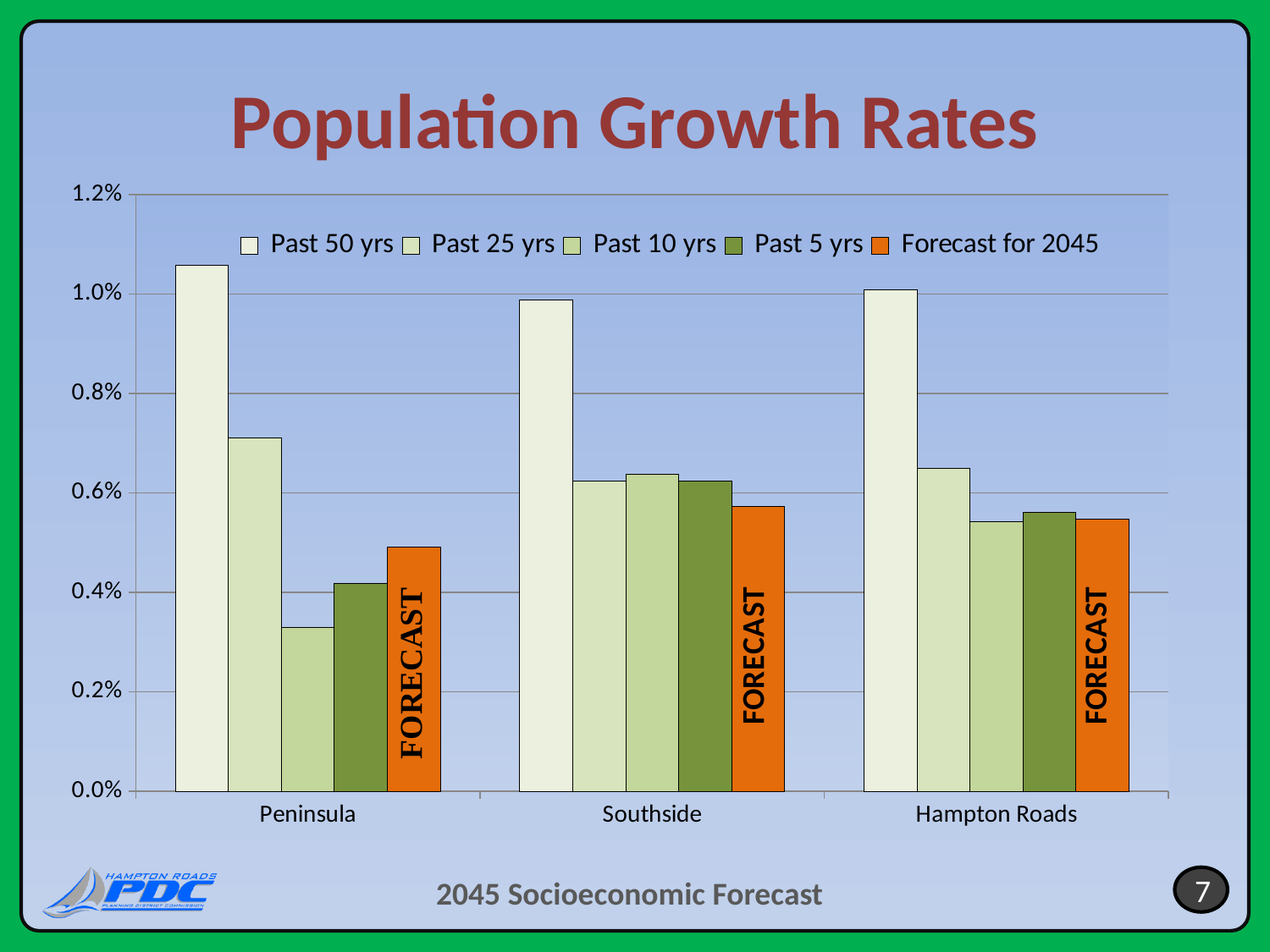
Is the Past 50 yrs value for Southside greater or less than 0.8%? greater Is the Past 50 yrs value for Peninsula greater or less than 1.0%? greater How many categories are shown on the x axis? 3 How many series does the legend list? 5 Is the Forecast for 2045 value for Southside greater or less than 0.6%? less Which is larger for Peninsula: the Past 25 yrs value or the Forecast for 2045 value? Past 25 yrs What kind of chart is shown on the slide? Bar chart For Peninsula, which series has the highest value? Past 50 yrs What is the title of the chart? Population Growth Rates For Peninsula, which series has the lowest value? Past 10 yrs